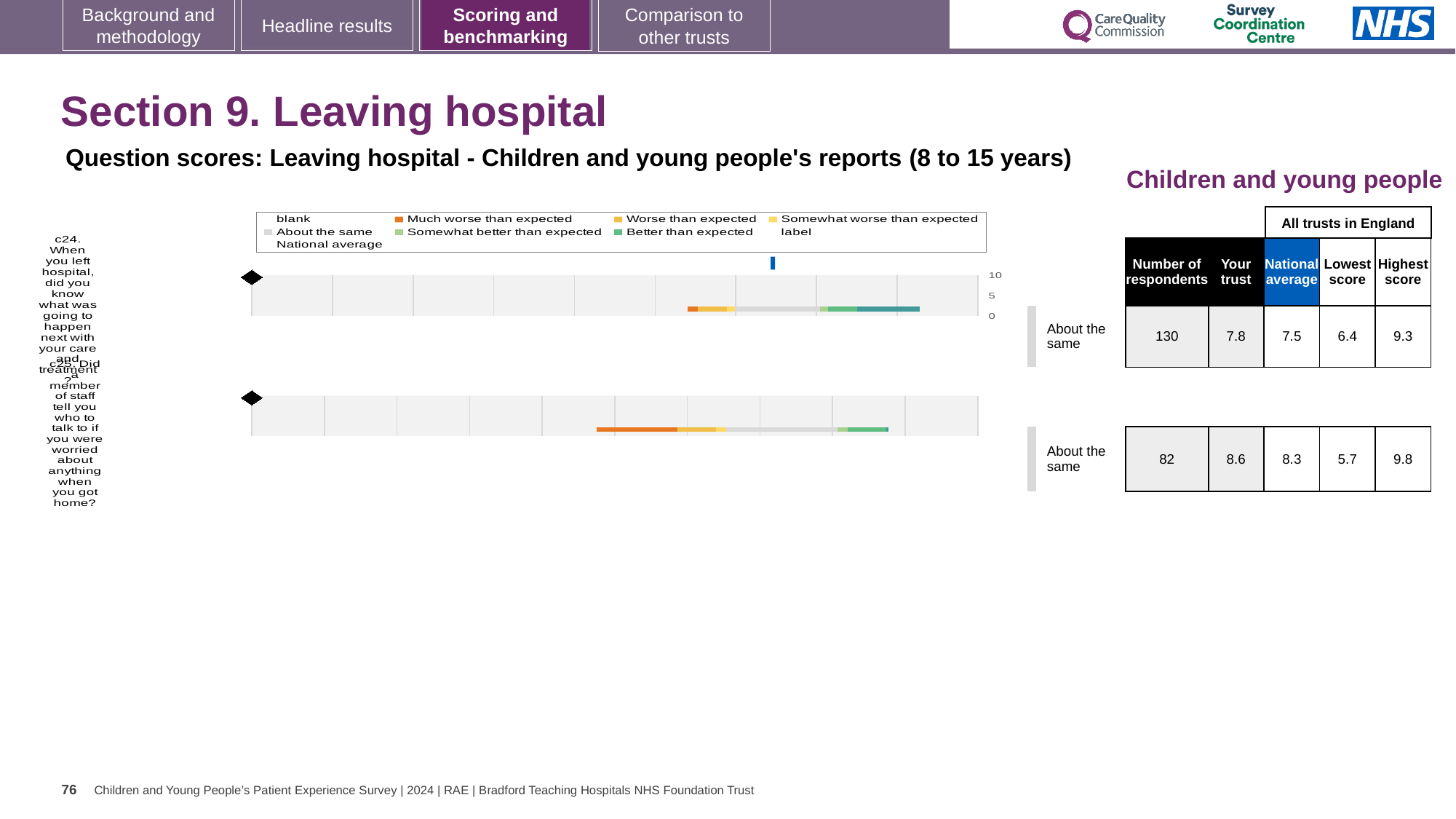
What is the title of the chart section on the slide? Question scores: Leaving hospital - Children and young people's reports (8 to 15 years) How many entries does the chart legend list? 9 What is the national average score for question c24? 7.5 What is the 'Your trust' score for question c24 (When you left hospital, did you know what was going to happen next with your care and treatment?)? 7.8 What kind of chart is used to show the benchmarking bands for questions c24 and c25? bar chart What is the difference between the trust's score and the national average for question c24? 0.3 What is the benchmarking category shown for question c24? About the same How many respondents answered question c25? 82 What is the 'Your trust' score for question c25 (Did a member of staff tell you who to talk to if you were worried about anything when you got home?)? 8.6 Which question has the higher 'Your trust' score, c24 or c25? c25 How many questions (bars) are plotted on the slide? 2 What is the highest score among all trusts in England for question c25? 9.8